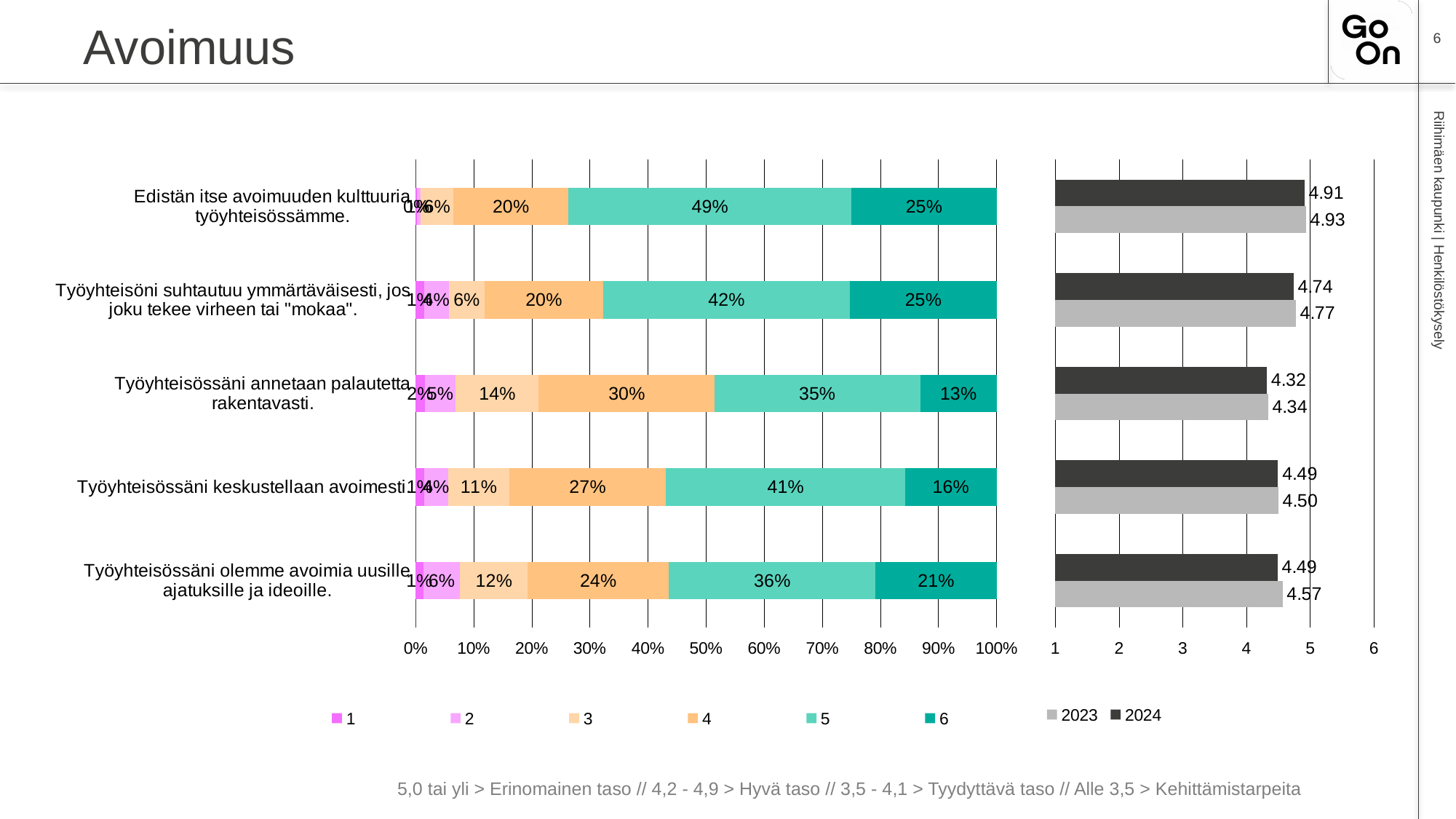
In the right bar chart, what is the 2023 value for "Työyhteisössäni olemme avoimia uusille ajatuksille ja ideoille."? 4.57 How many series does the legend of the left stacked bar chart list? 6 In the left stacked bar chart, what percentage of respondents gave a rating of 5 for "Edistän itse avoimuuden kulttuuria työyhteisössämme."? 49% In the left stacked bar chart, which statement has the highest share of rating 6? Edistän itse avoimuuden kulttuuria työyhteisössämme. and Työyhteisöni suhtautuu ymmärtäväisesti, jos joku tekee virheen tai "mokaa". (both 25%) In the left stacked bar chart, which statement has the lowest share of rating 6? Työyhteisössäni annetaan palautetta rakentavasti. In the left stacked bar chart, what percentage gave a rating of 4 for "Työyhteisössäni annetaan palautetta rakentavasti."? 30% In the left stacked bar chart, what is the difference between the rating-5 share for "Työyhteisössäni keskustellaan avoimesti." and the rating-5 share for "Työyhteisössäni annetaan palautetta rakentavasti."? 6 percentage points In the right bar chart, is the 2023 value for "Edistän itse avoimuuden kulttuuria työyhteisössämme." larger or smaller than its 2024 value? larger In the right bar chart, which statement has the lowest 2024 value? Työyhteisössäni annetaan palautetta rakentavasti. In the right bar chart, what is the 2024 value for "Työyhteisöni suhtautuu ymmärtäväisesti, jos joku tekee virheen tai "mokaa"."? 4.74 In the left stacked bar chart, what percentage gave a rating of 6 for "Työyhteisössäni olemme avoimia uusille ajatuksille ja ideoille."? 21% What type of chart is the right-hand chart? bar chart